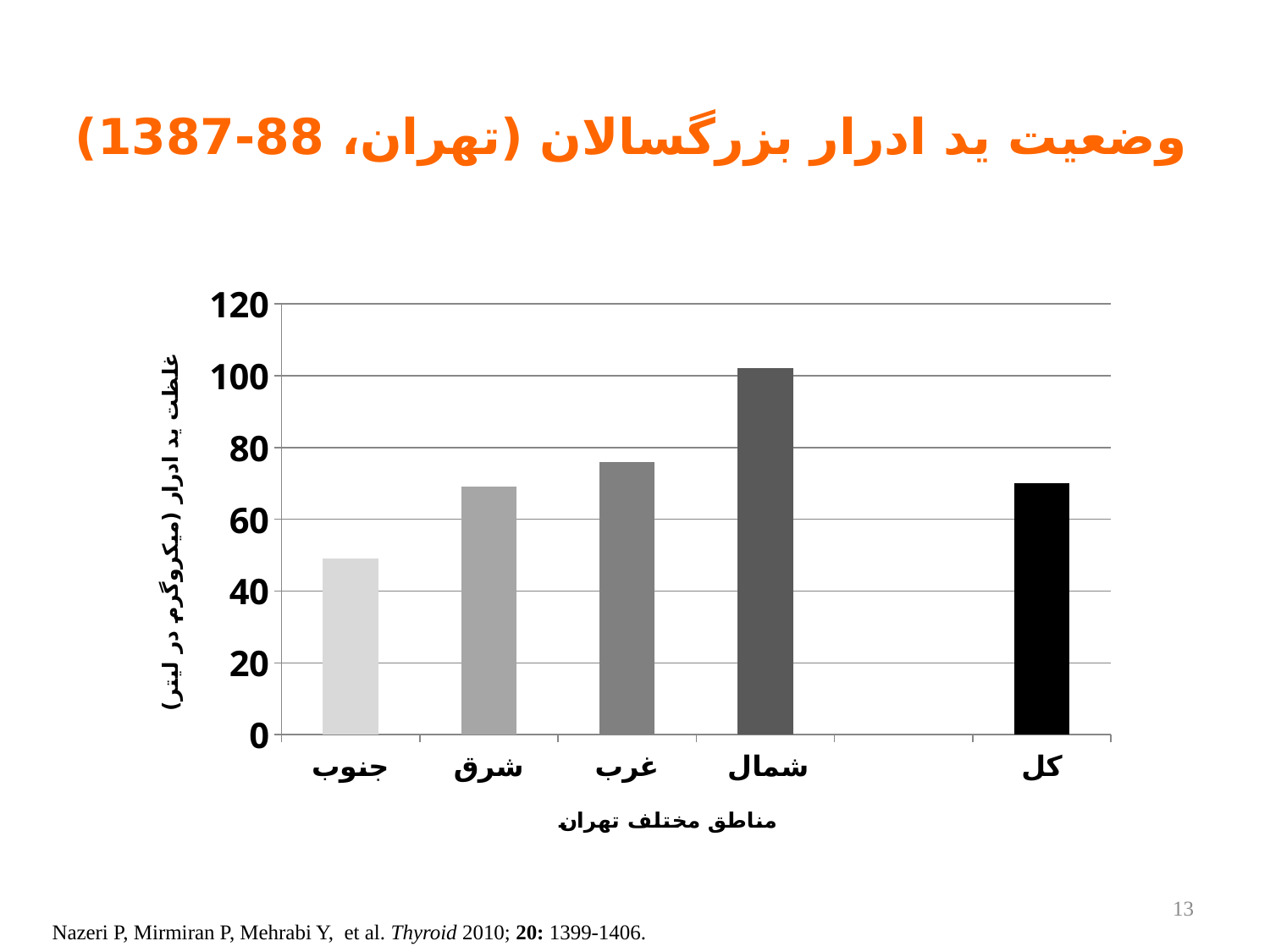
How many bars are shown in the chart? 5 Is the value for کل greater or less than 80? less Which category has the lowest bar in the chart? جنوب Is the value for غرب greater or less than 80? less Which is larger, the value for غرب or the value for جنوب? غرب Is the value for شرق greater or less than 60? greater What kind of chart is shown on the slide? bar chart What is the label of the x axis of the chart? مناطق مختلف تهران Which is larger, the value for شمال or the value for جنوب? شمال Which category has the highest bar in the chart? شمال